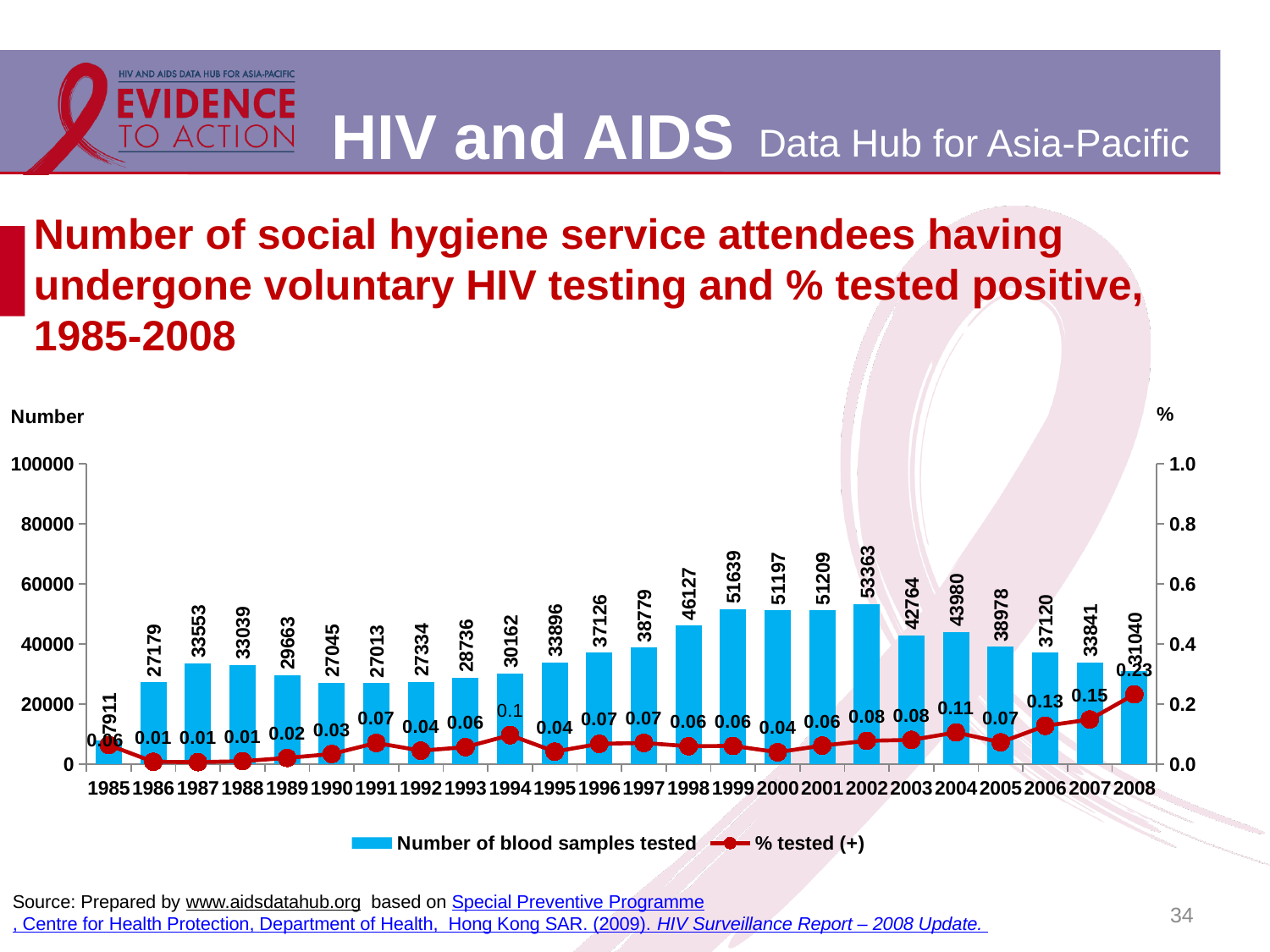
What was the number of blood samples tested in 1999? 51639 What was the number of blood samples tested in 2002? 53363 In which year was the number of blood samples tested highest? 2002 Which year had more blood samples tested, 1998 or 2004? 1998 In which year was the number of blood samples tested lowest? 1985 What was the % tested positive in 1994? 0.1 How many series does the legend list? 2 What is the difference between the number of blood samples tested in 2002 and in 2003? 10599 In which year was the % tested positive highest? 2008 Did the % tested positive rise or fall from 2005 to 2008? rise How many years are shown on the x axis? 24 What was the % tested positive in 2008? 0.23